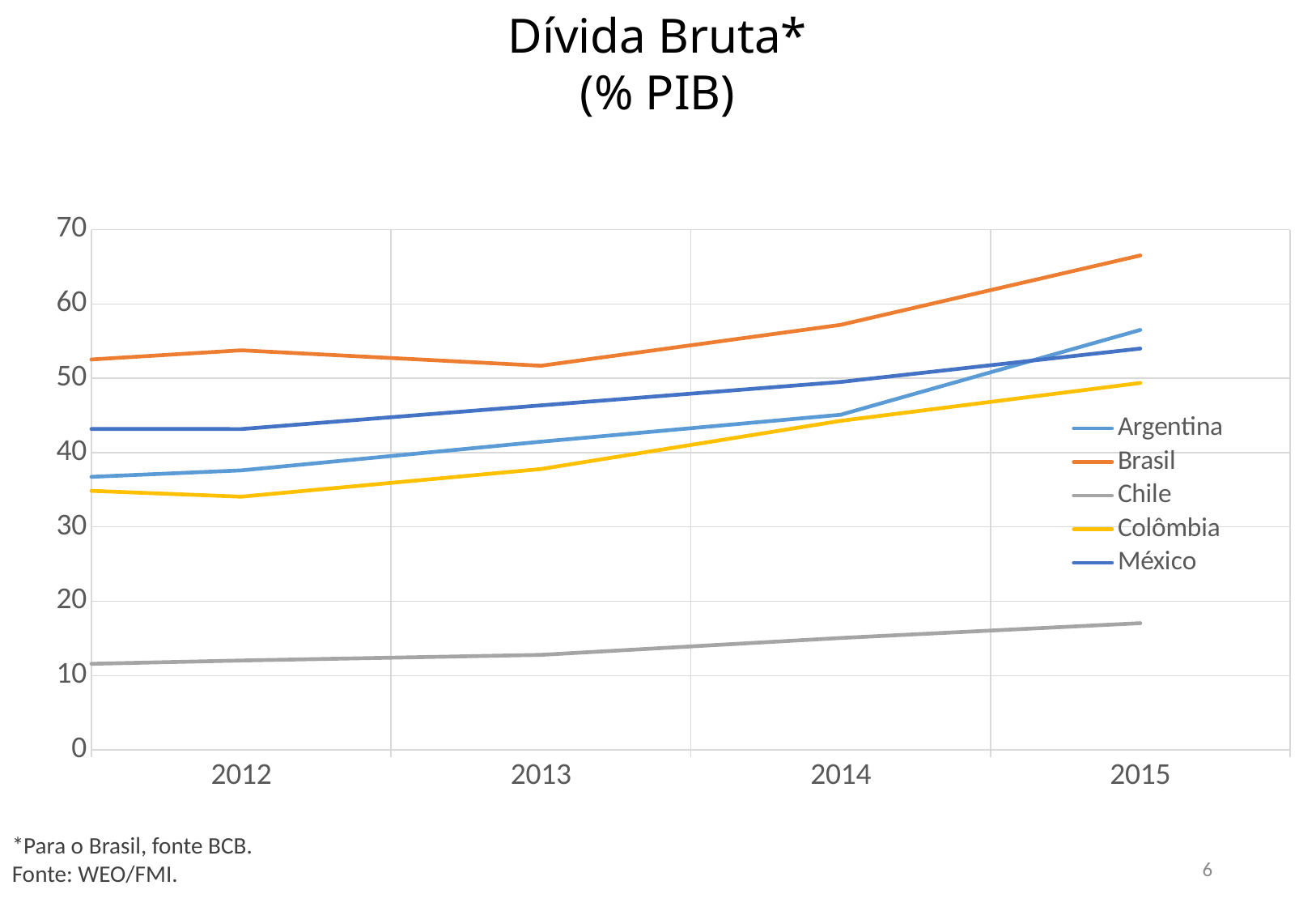
Which country has the lowest gross debt (% PIB) in 2015? Chile Does the line for Chile rise or fall from 2012 to 2015? rise Is the value for Brasil in 2015 greater or less than 60? greater How many years are shown on the x axis? 4 In 2012, which is larger: the value for Argentina or the value for México? México Is the value for Chile in 2015 greater or less than 20? less How many series does the legend list? 5 What is the title of the chart? Dívida Bruta* (% PIB) Which country has the highest gross debt (% PIB) in 2015? Brasil Is the value for Colômbia in 2012 greater or less than 40? less What kind of chart is shown on the slide? line chart In 2015, which is larger: the value for Argentina or the value for Colômbia? Argentina